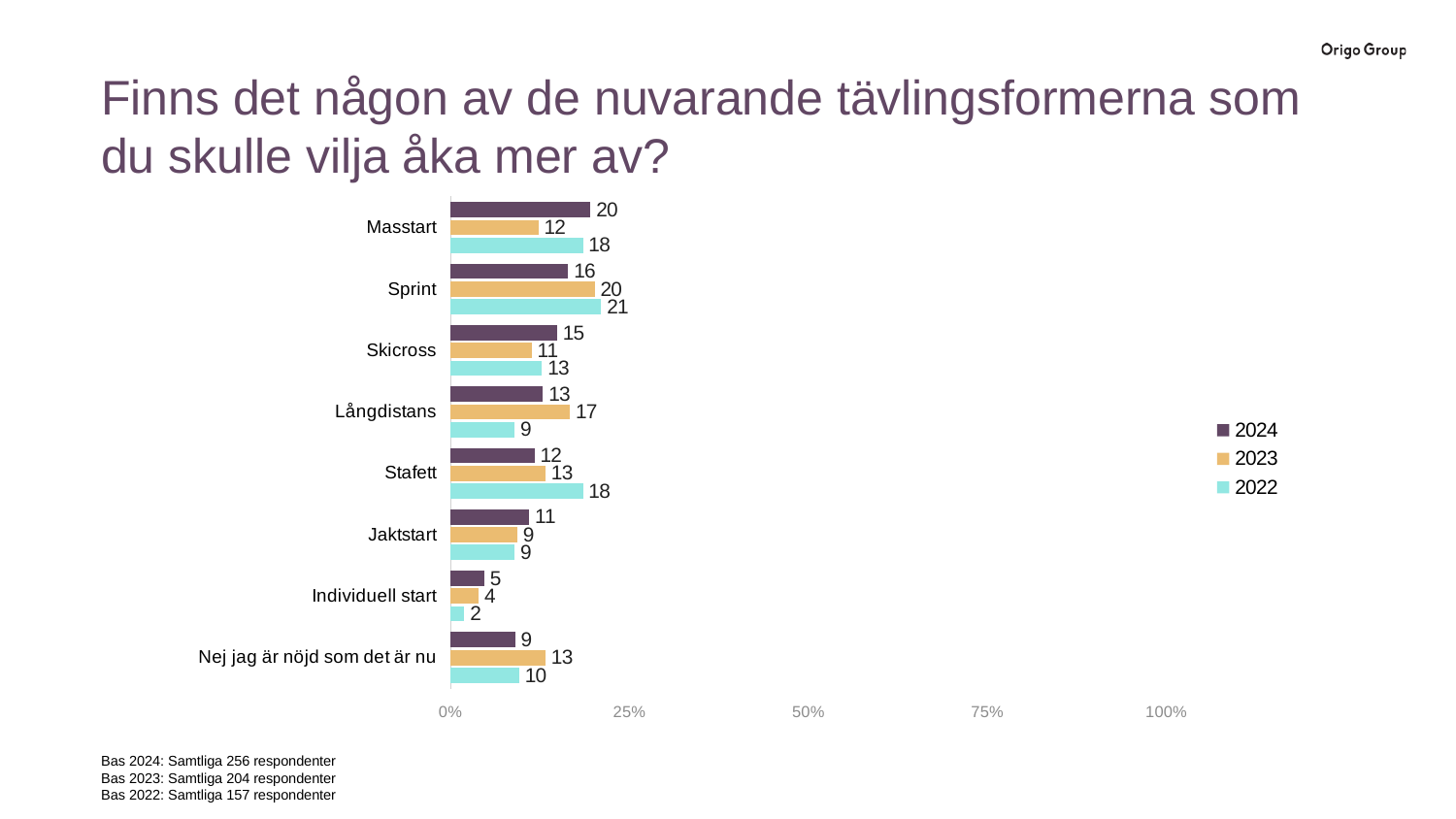
Which is larger for Sprint: the 2024 value or the 2022 value? 2022 What is the value for Långdistans in the 2023 series? 17 Is the 2022 value for Sprint greater or less than 25%? less Which series is shown in the light blue colour in the legend? 2022 What is the value for Masstart in the 2024 series? 20 What is the value for Stafett in the 2022 series? 18 How many categories are shown on the chart? 8 What kind of chart is shown on the slide? bar chart Which category has the highest value in the 2024 series? Masstart Which category has the lowest value in the 2022 series? Individuell start What is the difference between the 2024 and 2023 values for Masstart? 8 How many series does the legend list? 3